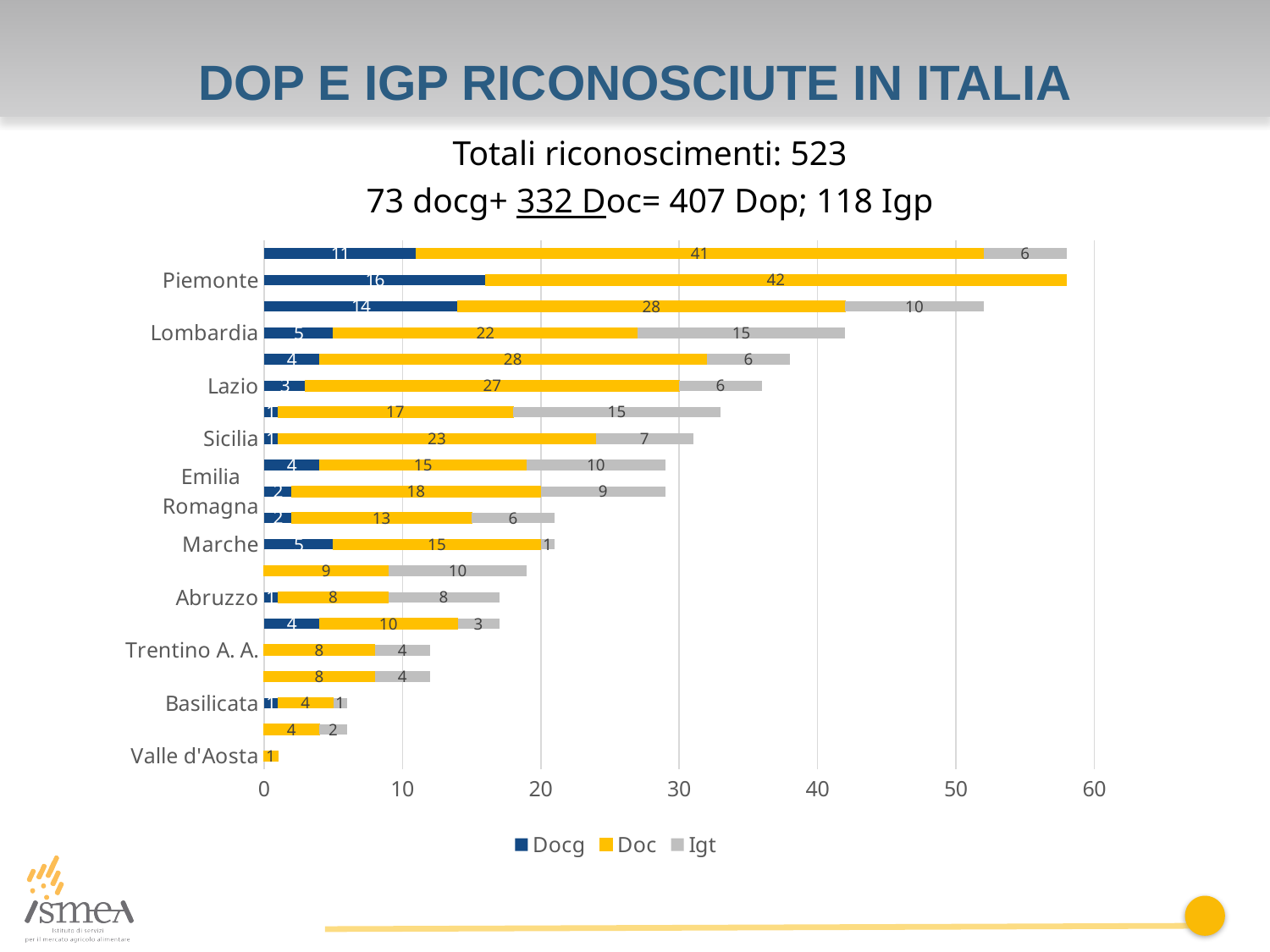
What is the difference between the Docg values of Piemonte and Lombardia? 11 Which has the larger Igt value, Lombardia or Lazio? Lombardia How many series does the legend list? 3 Which region has the highest Doc value? Piemonte What is the total of the stacked bar for Lombardia (Docg + Doc + Igt)? 42 Is the total bar for Piemonte greater or less than 50? greater What is the Igt value for Lombardia? 15 What is the total of the stacked bar for Emilia Romagna? 29 What is the Doc value for Piemonte? 42 What is the Doc value for Lazio? 27 What is the Docg value for Piemonte? 16 Which labeled region has the lowest total bar? Valle d'Aosta